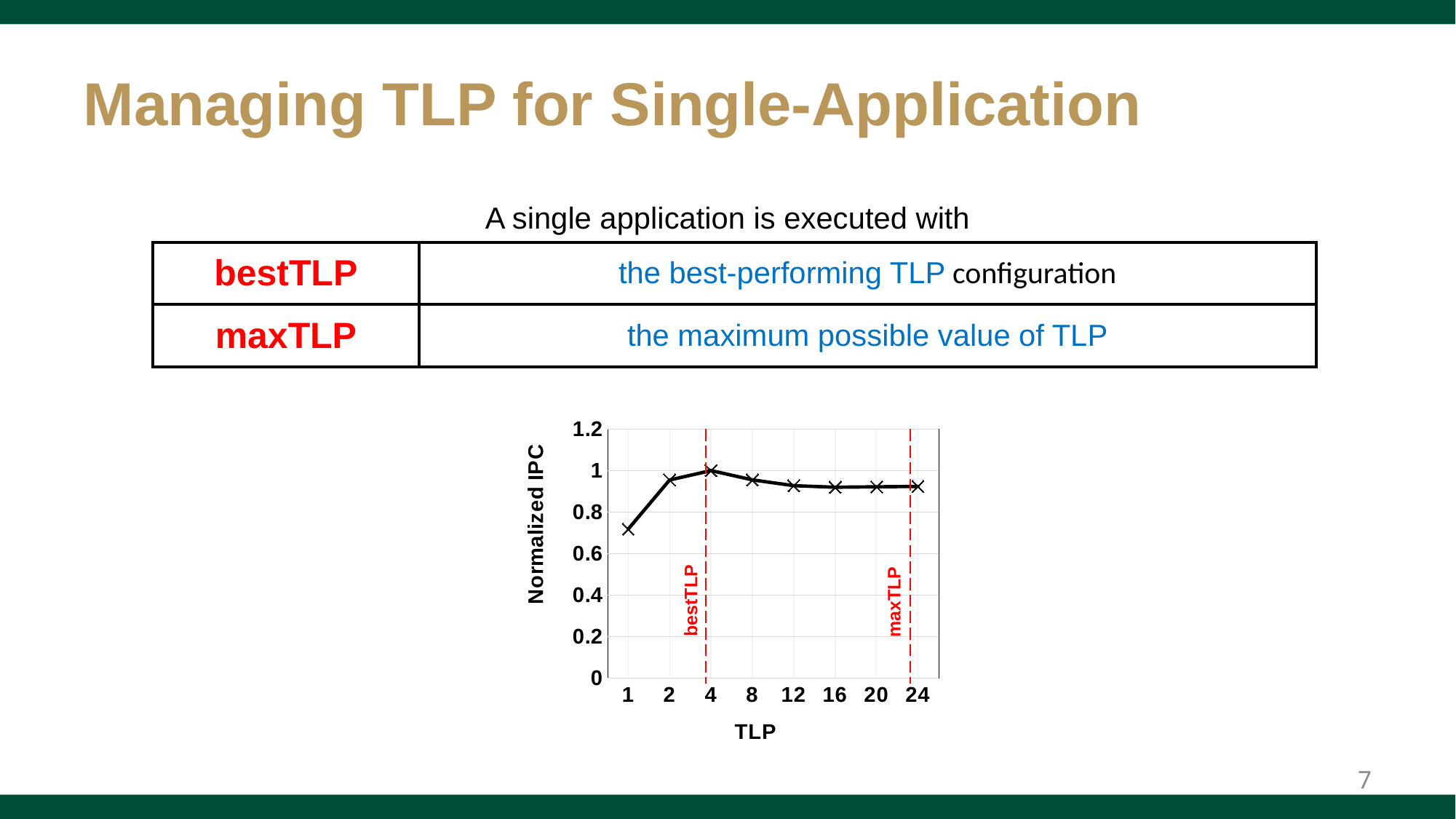
Is the Normalized IPC at TLP 1 greater or less than 0.6? greater At which TLP value is the Normalized IPC lowest? 1 At which TLP value is the Normalized IPC highest? 4 What is the Normalized IPC at TLP 4? 1 Does the Normalized IPC rise or fall from TLP 1 to TLP 4? rise What is the label of the y axis of the chart? Normalized IPC Is the Normalized IPC at TLP 1 greater or less than 0.8? less How many TLP values are plotted on the chart? 8 What kind of chart is shown on the slide? line chart At which TLP value is the dashed line labelled bestTLP drawn? 4 Which has a higher Normalized IPC, TLP 1 or TLP 2? TLP 2 Is the Normalized IPC at TLP 24 greater or less than 0.8? greater